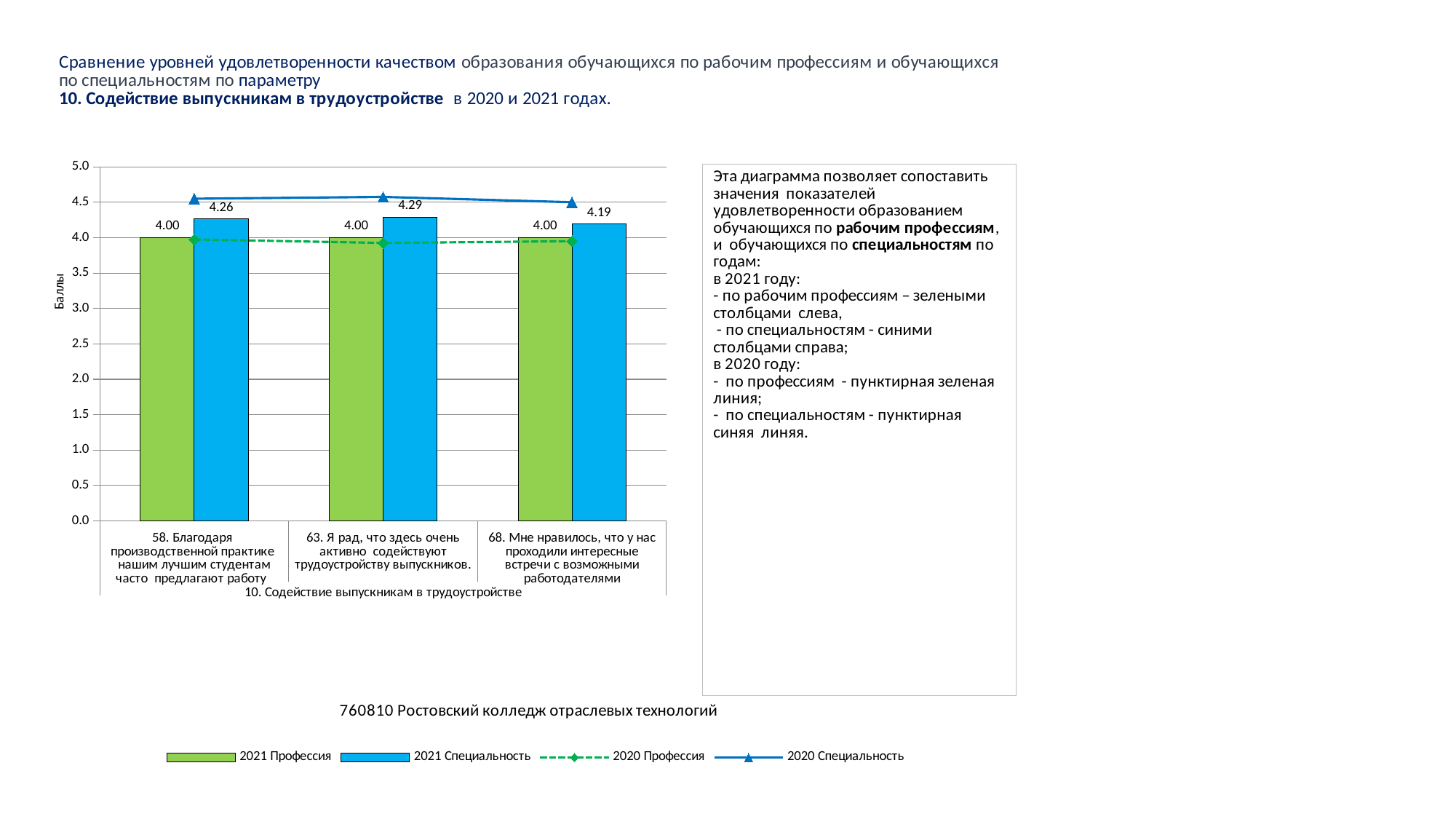
What is the difference between the 2021 Специальность values for category 63 and category 68? 0.10 Which category has the lowest value for the 2021 Специальность series? 68. Мне нравилось, что у нас проходили интересные встречи с возможными работодателями What is the value of the 2021 Специальность series for category 63 (Я рад, что здесь очень активно содействуют трудоустройству выпускников)? 4.29 What is the value of the 2021 Специальность series for category 68 (Мне нравилось, что у нас проходили интересные встречи с возможными работодателями)? 4.19 For category 58, what is the difference between the 2021 Специальность value and the 2021 Профессия value? 0.26 How many series does the legend list? 4 What is the value of the 2021 Профессия series for category 58 (Благодаря производственной практике нашим лучшим студентам часто предлагают работу)? 4.00 Is the 2020 Специальность value for category 63 greater or less than 4.0? greater How many categories are shown on the x axis of the chart? 3 Is the 2020 Профессия value for category 63 greater or less than 4.5? less For category 68, which is larger: the 2021 Профессия value or the 2021 Специальность value? 2021 Специальность Which category has the highest value for the 2021 Специальность series? 63. Я рад, что здесь очень активно содействуют трудоустройству выпускников.